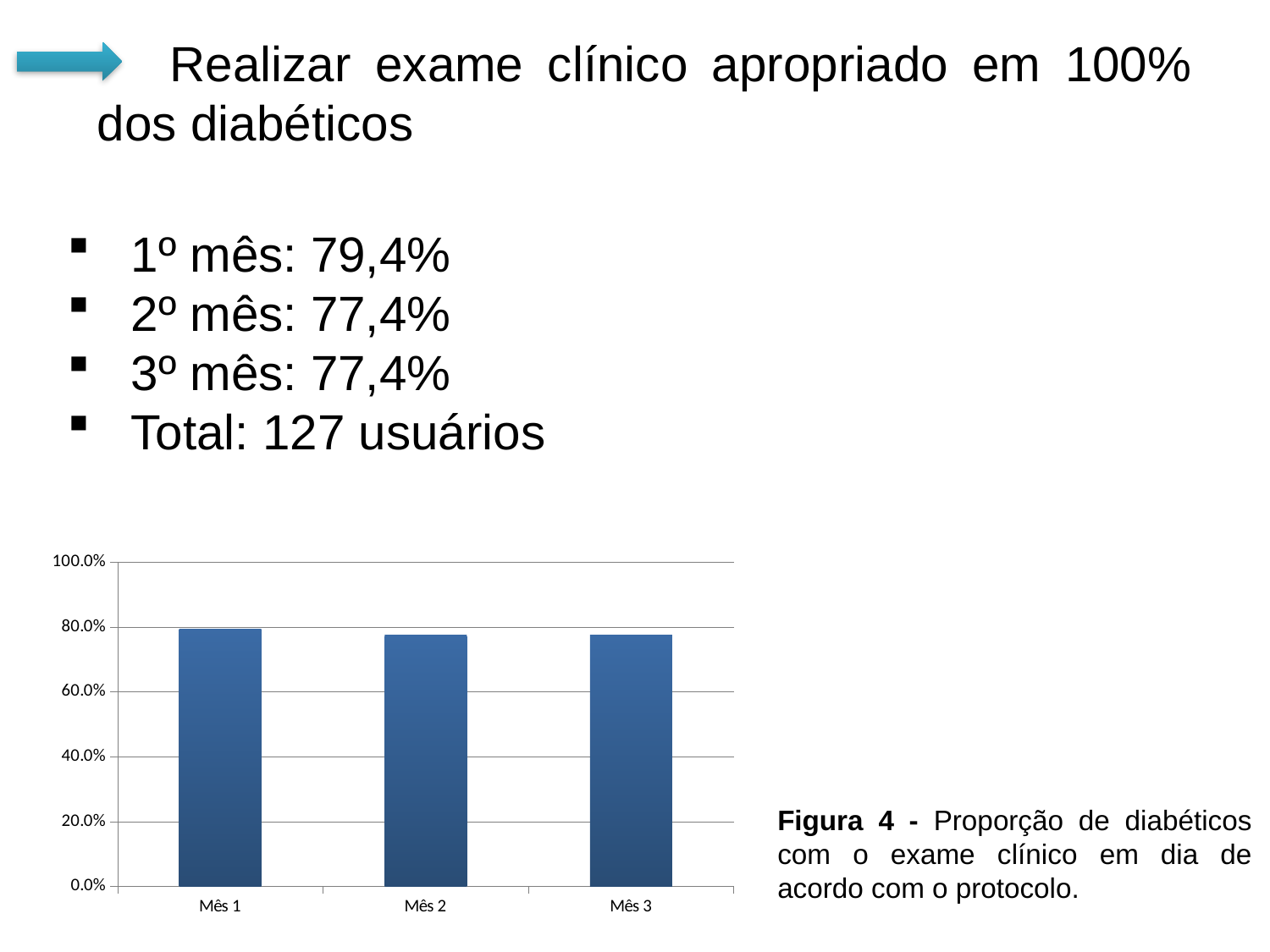
What kind of chart is shown on the slide? bar chart Is the value for Mês 3 greater or less than 80.0%? less Do the values rise or fall from Mês 1 to Mês 2? fall What figure number is given in the caption next to the chart? Figura 4 Which month has the highest bar in the chart? Mês 1 What is the highest tick value shown on the vertical axis of the chart? 100.0% According to the slide, what is the proportion for the 1º mês? 79,4% Is the value for Mês 1 greater or less than 80.0%? less Which is larger, the value for Mês 1 or the value for Mês 2? Mês 1 According to the slide, what is the proportion for the 3º mês? 77,4% How many bars (months) are plotted in the chart? 3 Is the value for Mês 2 greater or less than 60.0%? greater